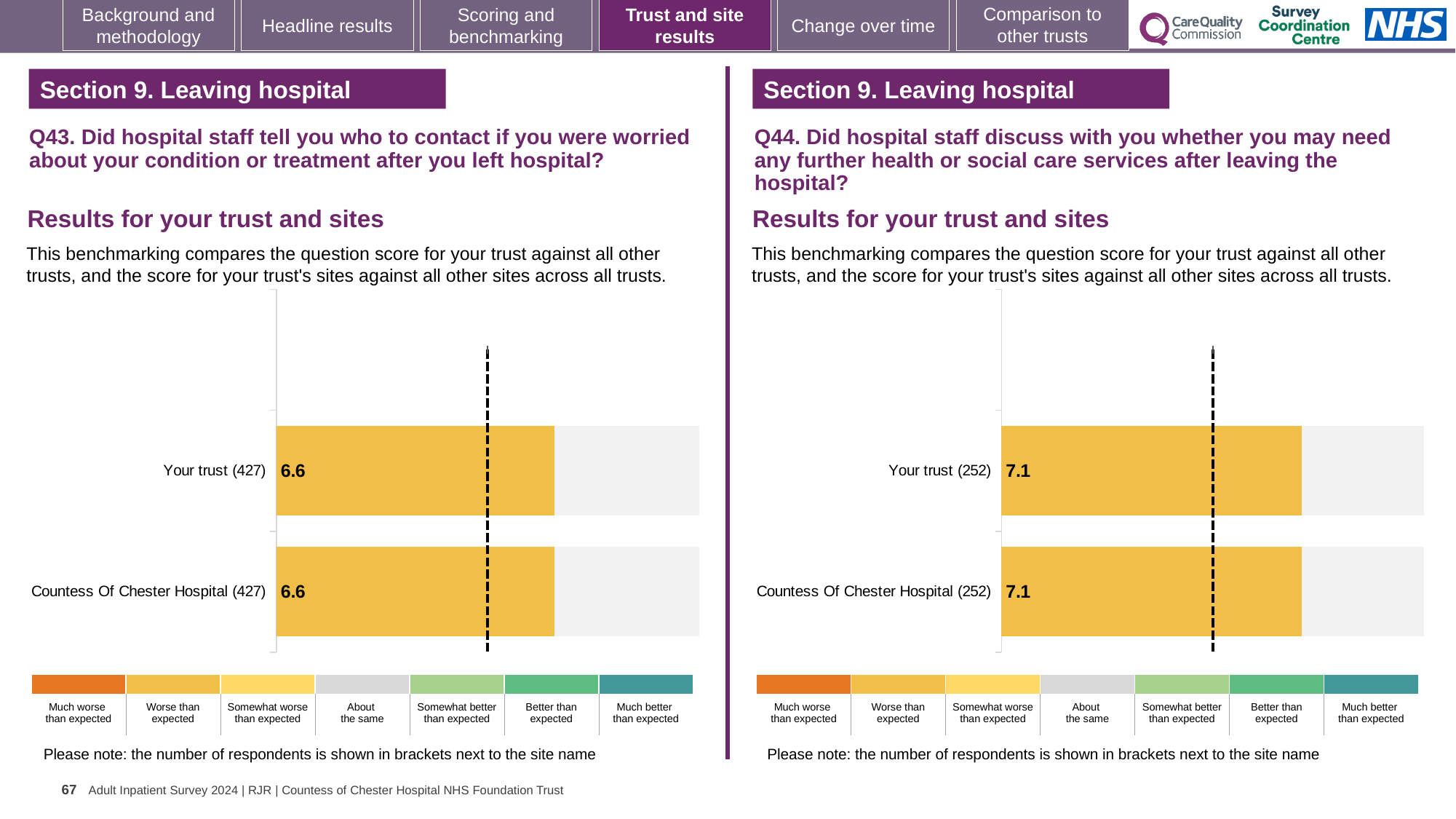
On the Q44 chart (right), what is the score for Countess Of Chester Hospital? 7.1 On the Q44 chart (right), what is the score for Your trust? 7.1 On the Q43 chart (left), what is the score for Your trust? 6.6 What type of chart is used on the Q43 chart (left)? Bar chart On the Q44 chart (right), what is the difference between the score for Your trust and the score for Countess Of Chester Hospital? 0.0 How many bars are plotted on the Q44 chart (right)? 2 On the Q44 chart (right), how many respondents are shown in brackets for Countess Of Chester Hospital? 252 According to the colour key below the Q44 chart (right), which category does the colour of the plotted bars correspond to? Worse than expected On the Q43 chart (left), what is the score for Countess Of Chester Hospital? 6.6 On the Q43 chart (left), how many respondents are shown in brackets for Your trust? 427 How many bars are plotted on the Q43 chart (left)? 2 On the Q43 chart (left), what is the difference between the score for Your trust and the score for Countess Of Chester Hospital? 0.0